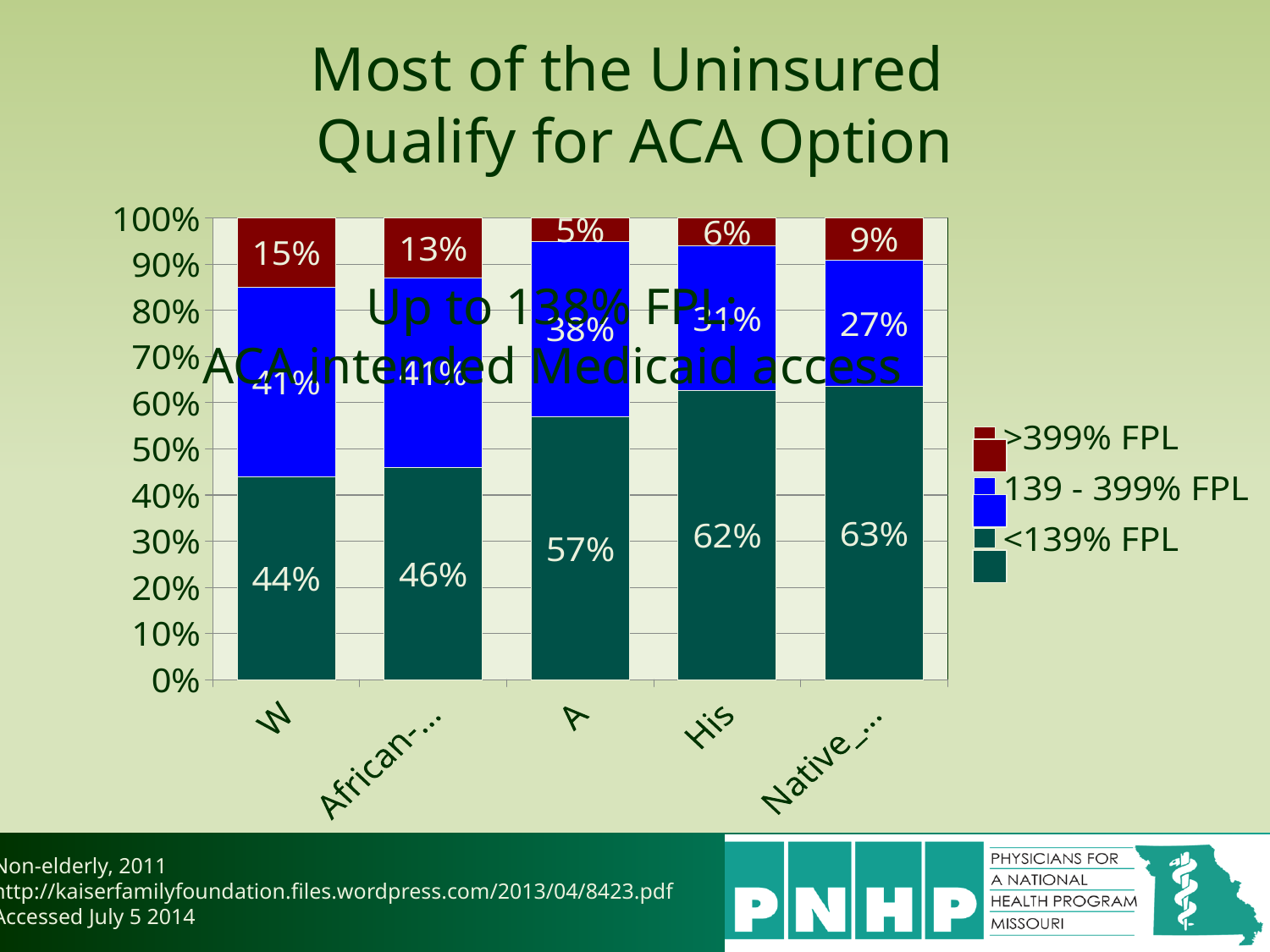
What kind of chart is shown on the slide? Stacked bar chart How many bars (categories) are plotted in the chart? 5 Which category has the lowest <139% FPL value? W What is the >399% FPL value for the A category? 5% What is the >399% FPL value for the W category? 15% What is the <139% FPL value for the A category? 57% What is the <139% FPL value for the His category? 62% How much larger is the <139% FPL value for His than for W? 18 percentage points How many series does the legend list? 3 Does the <139% FPL value rise or fall moving from left to right across the bars? Rises Which category has the highest >399% FPL value? W Which has the larger >399% FPL value, W or A? W